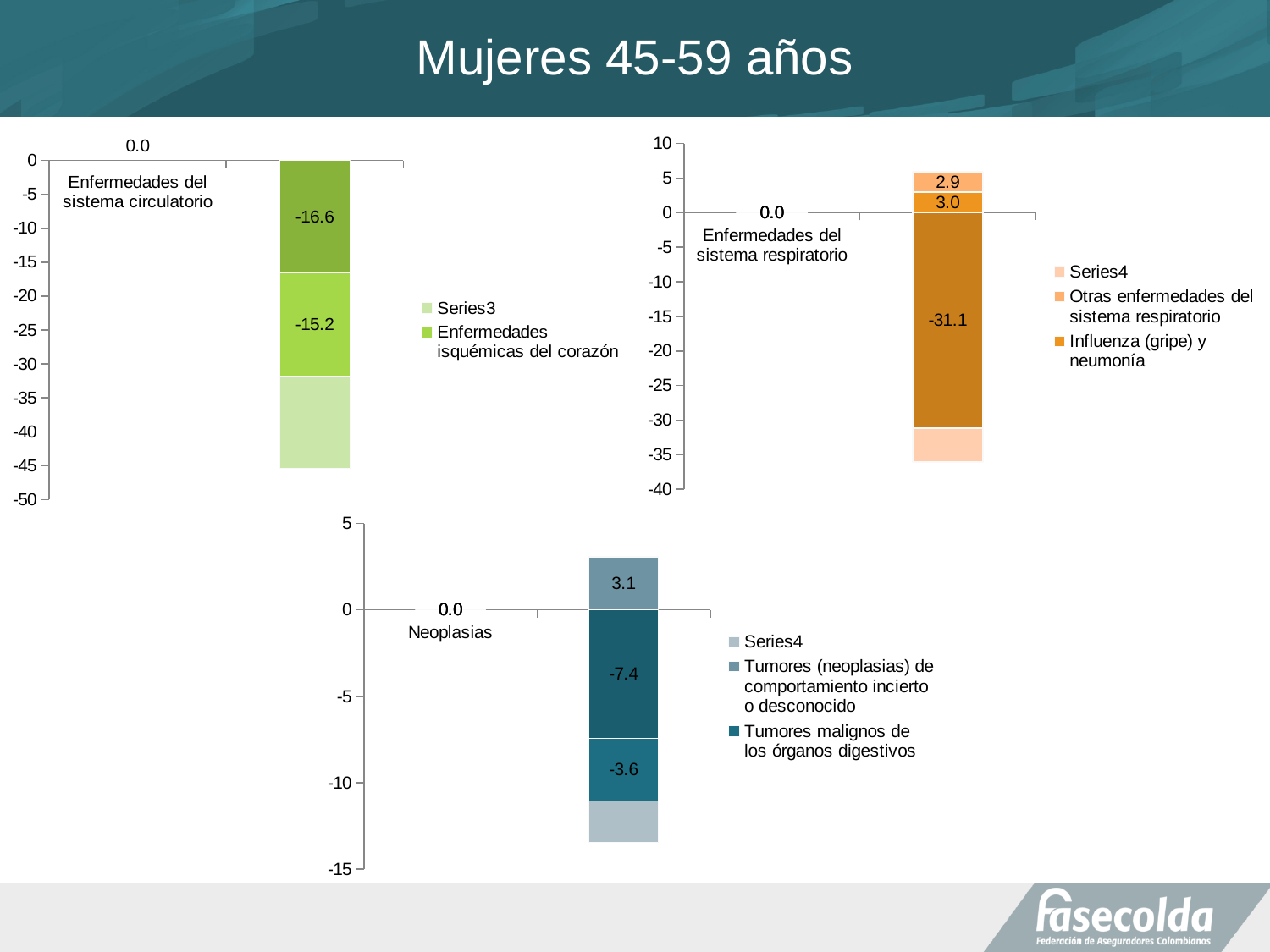
In the top-right chart (Enfermedades del sistema respiratorio), what is the value for Influenza (gripe) y neumonía? 3.0 What kind of chart is the bottom chart labelled Neoplasias? bar chart In the bottom chart (Neoplasias), what is the value for Tumores (neoplasias) de comportamiento incierto o desconocido? 3.1 What is the title of the slide containing these charts? Mujeres 45-59 años How many series does the legend of the top-left chart (Enfermedades del sistema circulatorio) list? 2 How many series does the legend of the bottom chart (Neoplasias) list? 3 In the top-left chart (Enfermedades del sistema circulatorio), what is the difference between the labelled values -16.6 and -15.2? 1.4 How many series does the legend of the top-right chart (Enfermedades del sistema respiratorio) list? 3 In the bottom chart (Neoplasias), what is the value for Tumores malignos de los órganos digestivos? -3.6 In the bottom chart (Neoplasias), what is the difference between the values -7.4 and -3.6? 3.8 In the top-right chart (Enfermedades del sistema respiratorio), what is the value for Otras enfermedades del sistema respiratorio? 2.9 In the top-left chart (Enfermedades del sistema circulatorio), what is the value for Enfermedades isquémicas del corazón? -15.2